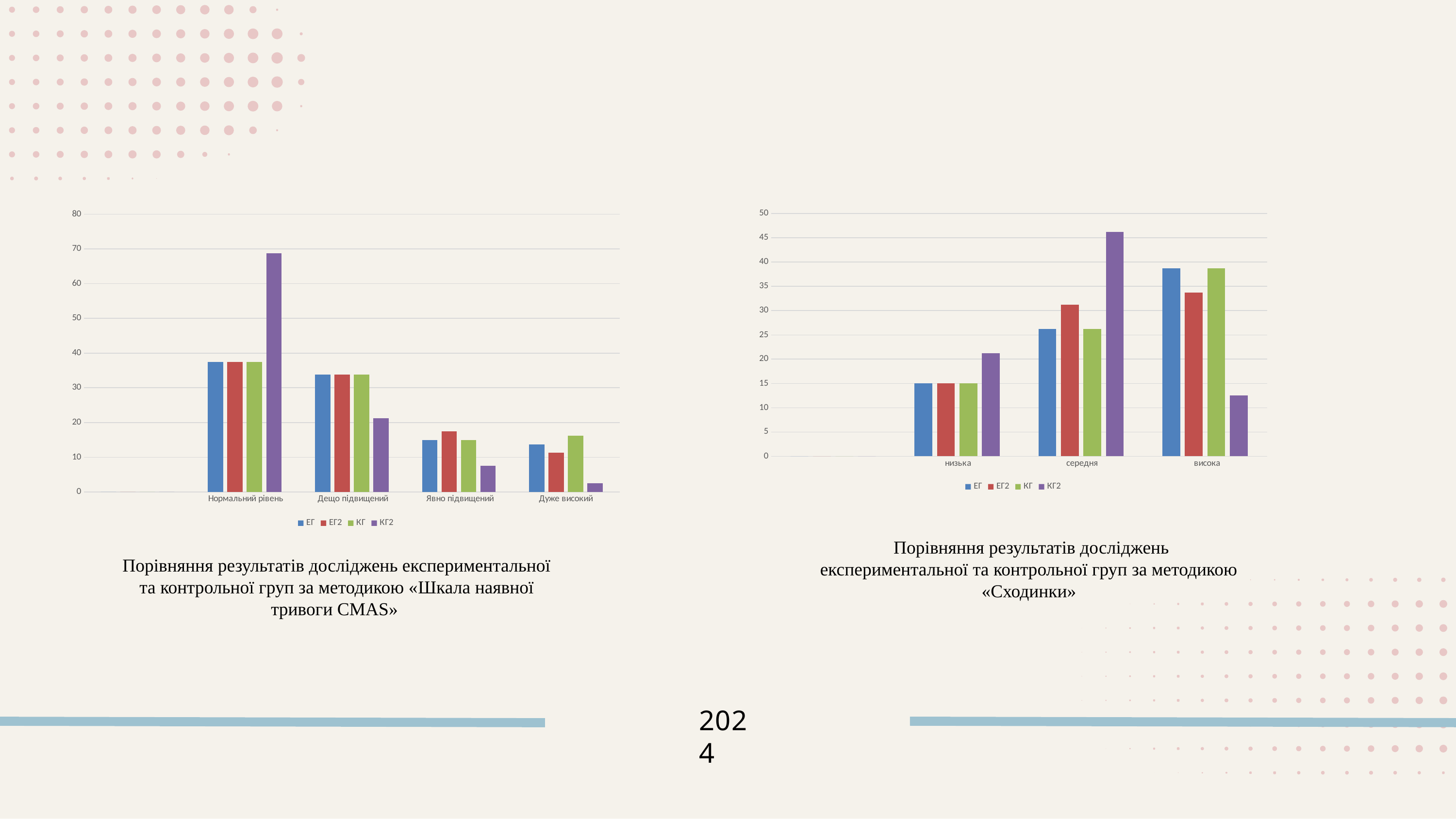
In the left chart (Шкала наявної тривоги CMAS), is the value of КГ2 for Дуже високий greater or less than 10? less In the right chart (Сходинки), which is larger for the висока category: ЕГ or ЕГ2? ЕГ In the left chart (Шкала наявної тривоги CMAS), which series has the highest bar in the Нормальний рівень category? КГ2 How many categories are shown on the x axis of the left chart (Шкала наявної тривоги CMAS)? 4 In the left chart (Шкала наявної тривоги CMAS), is the value of КГ2 for Нормальний рівень greater or less than 60? greater In the right chart (Сходинки), is the value of КГ2 for середня greater or less than 40? greater How many categories are shown on the x axis of the right chart (Сходинки)? 3 In the right chart (Сходинки), which series has the highest bar in the середня category? КГ2 What kind of chart is the left chart (Шкала наявної тривоги CMAS)? bar chart In the left chart (Шкала наявної тривоги CMAS), do the КГ2 values rise or fall from Нормальний рівень to Дуже високий? fall In the right chart (Сходинки), which series has the lowest bar in the висока category? КГ2 How many series does the legend of the right chart (Сходинки) list? 4